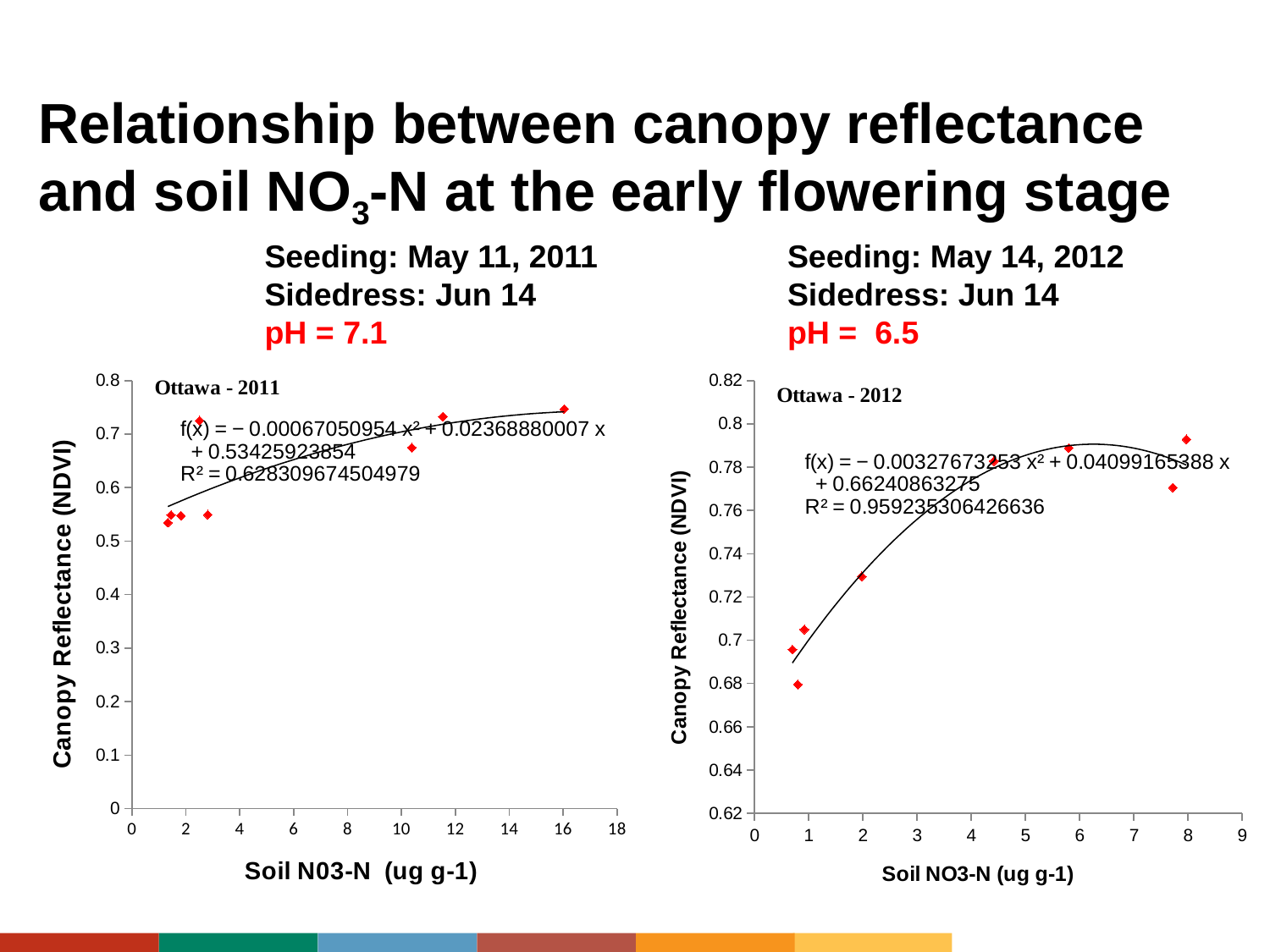
What kind of chart is the Ottawa - 2011 chart on the left? Scatter chart In the Ottawa - 2012 chart, is the canopy reflectance of the point at about 6 ug g-1 soil NO3-N greater or less than 0.76? greater In the Ottawa - 2011 chart, is the canopy reflectance of the cluster of points near 1-2 ug g-1 soil NO3-N greater or less than 0.6? less In the Ottawa - 2011 chart, what is the highest value shown on the x axis? 18 In the Ottawa - 2011 chart, what is the R² value shown? 0.628309674504979 In the Ottawa - 2012 chart, is the canopy reflectance of the point at about 2 ug g-1 soil NO3-N greater or less than 0.76? less Which chart shows the higher R² value, Ottawa - 2011 or Ottawa - 2012? Ottawa - 2012 In the Ottawa - 2012 chart, does canopy reflectance generally rise or fall as soil NO3-N increases from 0 to 6 ug g-1? rise In the Ottawa - 2012 chart, what is the R² value shown? 0.959235306426636 What is the y-axis label of the Ottawa - 2012 chart? Canopy Reflectance (NDVI)